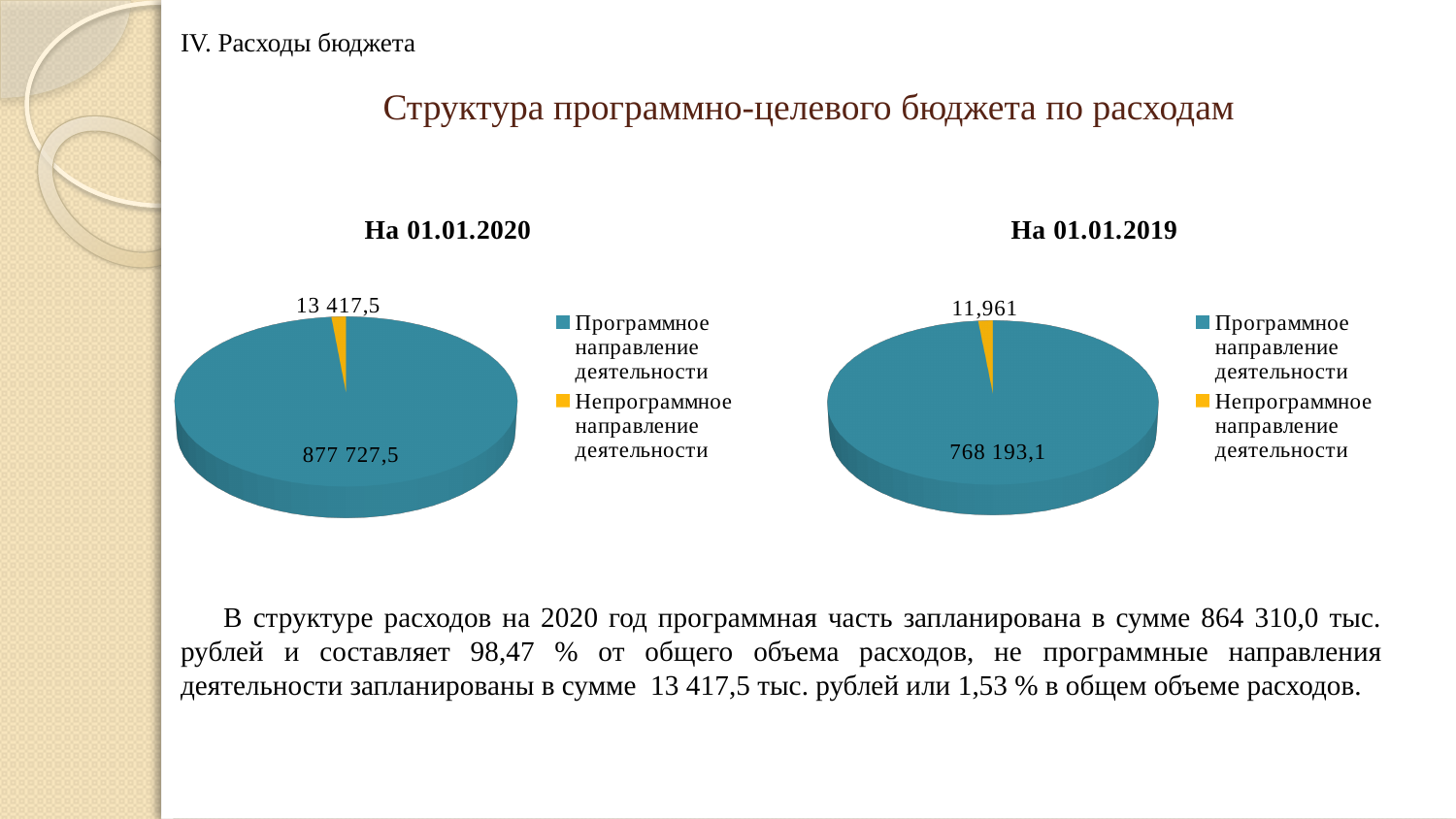
On the chart titled "На 01.01.2020", what is the value for Программное направление деятельности? 877 727,5 On the chart titled "На 01.01.2019", what colour is the slice for Непрограммное направление деятельности? Yellow Which is larger: the value for Программное направление деятельности on the "На 01.01.2020" chart or on the "На 01.01.2019" chart? На 01.01.2020 On the chart titled "На 01.01.2020", what is the value for Непрограммное направление деятельности? 13 417,5 On the chart titled "На 01.01.2019", which category has the smallest slice? Непрограммное направление деятельности On the chart titled "На 01.01.2019", what is the value for Непрограммное направление деятельности? 11,961 On the chart titled "На 01.01.2019", what is the value for Программное направление деятельности? 768 193,1 On the chart titled "На 01.01.2020", which category has the largest slice? Программное направление деятельности How many slices does the chart titled "На 01.01.2019" have? 2 On the chart titled "На 01.01.2020", what is the difference between the values for Программное направление деятельности and Непрограммное направление деятельности? 864 310,0 What kind of chart is the chart titled "На 01.01.2020"? Pie chart How many entries does the legend of the chart titled "На 01.01.2020" list? 2